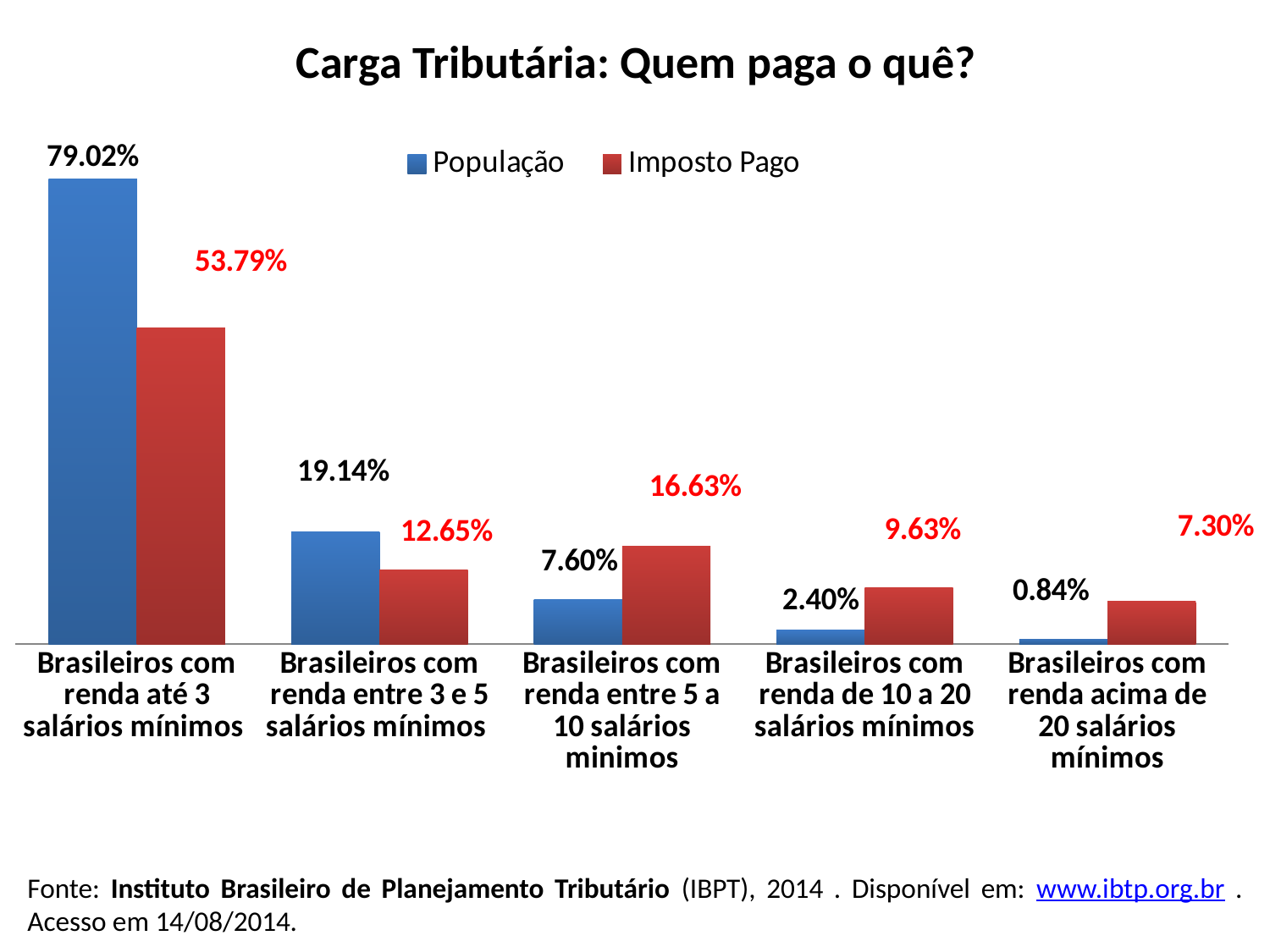
What is the População value for Brasileiros com renda até 3 salários mínimos? 79.02% What is the Imposto Pago value for Brasileiros com renda entre 5 a 10 salários minimos? 16.63% Which category has the highest Imposto Pago value? Brasileiros com renda até 3 salários mínimos Which category has the lowest População value? Brasileiros com renda acima de 20 salários mínimos How many income categories are shown on the x axis? 5 What is the difference between the População and Imposto Pago values for Brasileiros com renda até 3 salários mínimos? 25.23% What is the População value for Brasileiros com renda de 10 a 20 salários mínimos? 2.40% For Brasileiros com renda entre 3 e 5 salários mínimos, which is larger: População or Imposto Pago? População What kind of chart is shown on the slide? Bar chart Do the População values rise or fall from left to right along the x axis? Fall How many series does the legend list? 2 What is the Imposto Pago value for Brasileiros com renda acima de 20 salários mínimos? 7.30%